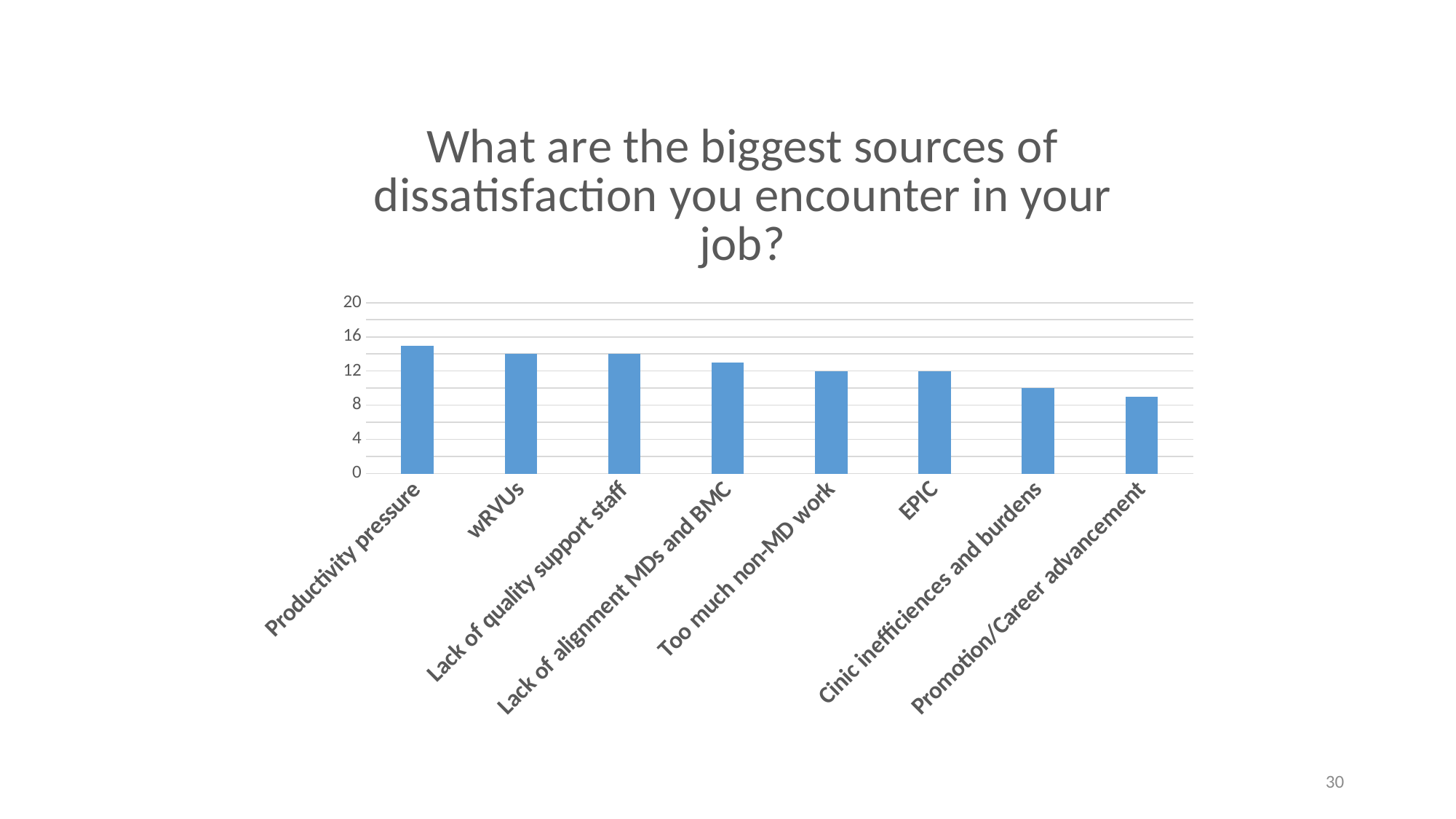
Is the value for Productivity pressure greater or less than 12? greater Which is larger, the value for Productivity pressure or the value for Promotion/Career advancement? Productivity pressure Is the value for Cinic inefficiences and burdens greater or less than 12? less What kind of chart is shown on the slide? bar chart Is the value for wRVUs greater or less than 12? greater Which category has the highest value in the chart? Productivity pressure How many categories are shown in the chart? 8 Which category has the lowest value in the chart? Promotion/Career advancement What is the title of the chart? What are the biggest sources of dissatisfaction you encounter in your job? Do the values rise or fall from left to right across the categories? fall